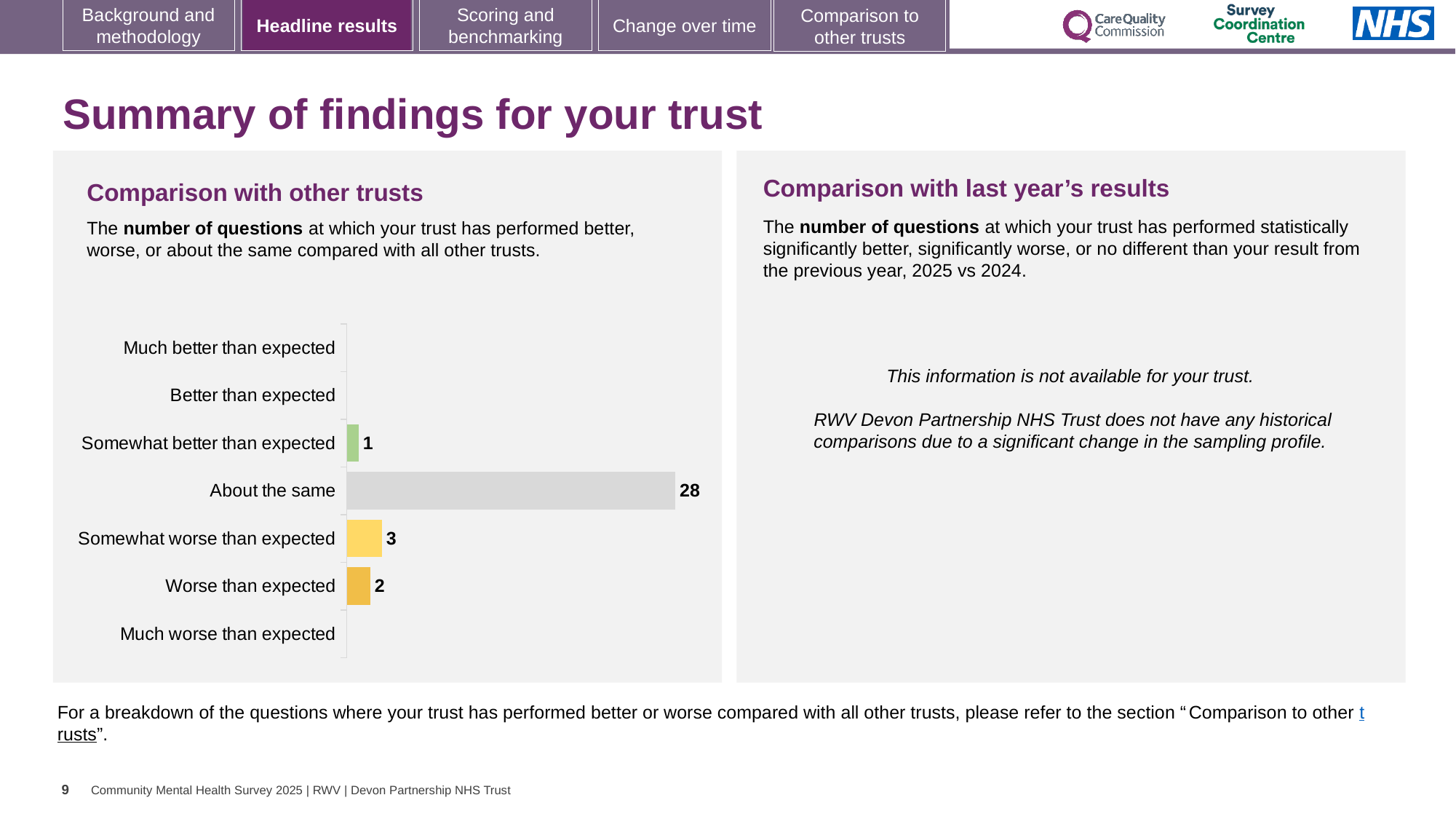
How many questions are in the "About the same" category? 28 What is the value for "Worse than expected"? 2 What kind of chart is shown under "Comparison with other trusts"? bar chart What is the value for "Somewhat better than expected"? 1 What is the difference between "Somewhat worse than expected" and "Worse than expected"? 1 What is the difference between the "About the same" value and the "Somewhat worse than expected" value? 25 How many categories are listed on the chart's vertical axis? 7 Which is larger, the value for "Somewhat worse than expected" or the value for "Somewhat better than expected"? Somewhat worse than expected Which category has the highest number of questions? About the same What is the title of the chart on the left panel? Comparison with other trusts What is the value for "Somewhat worse than expected"? 3 What colour is the bar for "About the same"? grey